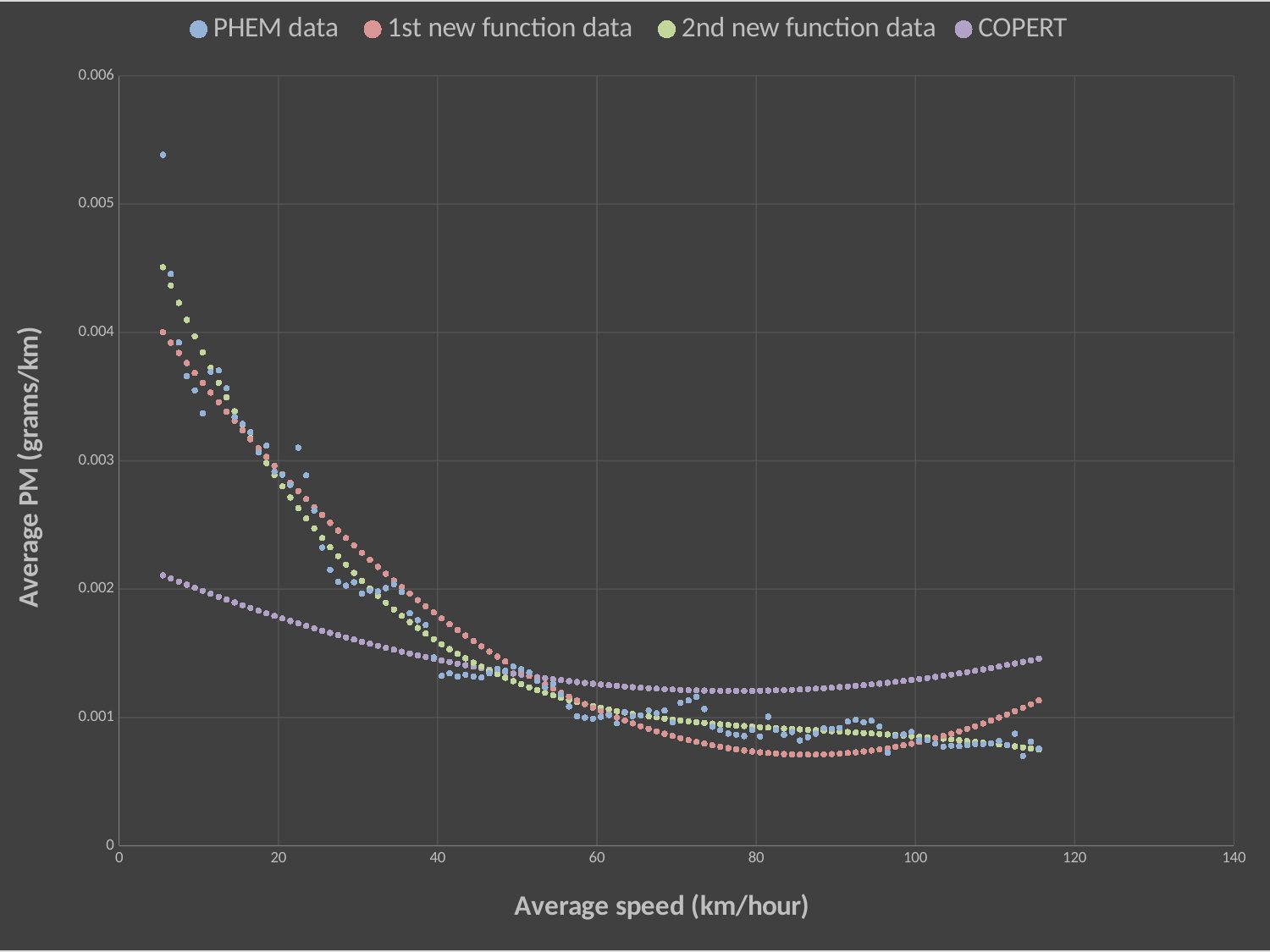
Is the 1st new function data value at 80 km/hour greater or less than 0.001? less What are the four series named in the legend? PHEM data, 1st new function data, 2nd new function data, COPERT Do the COPERT values rise or fall as average speed increases from 0 to 80 km/hour? fall What kind of chart is shown on the slide? scatter chart At 100 km/hour, which series has the higher value: COPERT or 1st new function data? COPERT What is the title of the x axis? Average speed (km/hour) How many series does the legend list? 4 At 10 km/hour, which series has the higher value: PHEM data or COPERT? PHEM data Which series has the lowest value at 85 km/hour? 1st new function data Is the COPERT value at 115 km/hour greater or less than 0.001? greater Do the COPERT values rise or fall as average speed increases from 90 to 115 km/hour? rise Is the COPERT value at 40 km/hour greater or less than 0.002? less